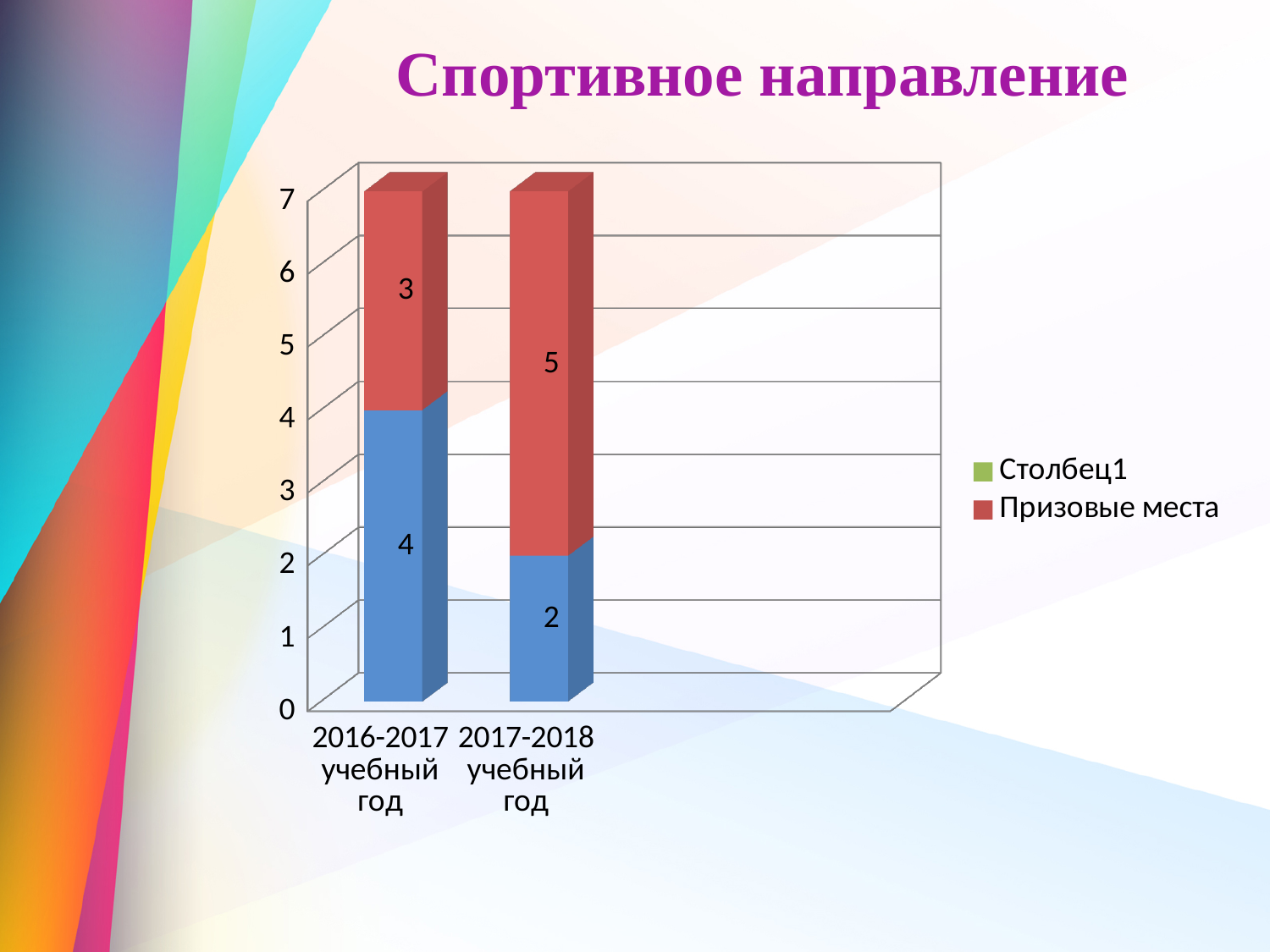
What is the total of the stacked bar for 2016-2017 учебный год? 7 How many entries does the legend list? 2 What is the value of the Призовые места segment for 2016-2017 учебный год? 3 What is the difference between the Призовые места values for 2017-2018 and 2016-2017? 2 What is the value of the blue segment for 2017-2018 учебный год? 2 What is the value of the blue segment for 2016-2017 учебный год? 4 Does the Призовые места value rise or fall from 2016-2017 to 2017-2018? Rise What is the value of the Призовые места segment for 2017-2018 учебный год? 5 How many categories are shown on the x axis? 2 Which year has the larger Призовые места value, 2016-2017 or 2017-2018? 2017-2018 учебный год What is the total of the stacked bar for 2017-2018 учебный год? 7 What kind of chart is shown on the slide? Stacked bar chart